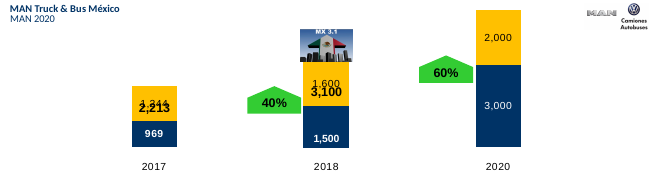
What growth percentage is shown between 2018 and 2020? 60% What is the value of the yellow segment for 2020? 2,000 What is the value of the dark blue segment for 2017? 969 What is the value of the yellow segment for 2018? 1,600 What is the difference between the dark blue segments for 2020 and 2018? 1,500 What is the value of the dark blue segment for 2020? 3,000 Which year has the tallest bar? 2020 What is the value of the dark blue segment for 2018? 1,500 Which year has the shortest bar? 2017 What is the total shown for the 2018 bar? 3,100 What is the total of the 2020 stacked bar? 5,000 How many years are shown on the x axis? 3